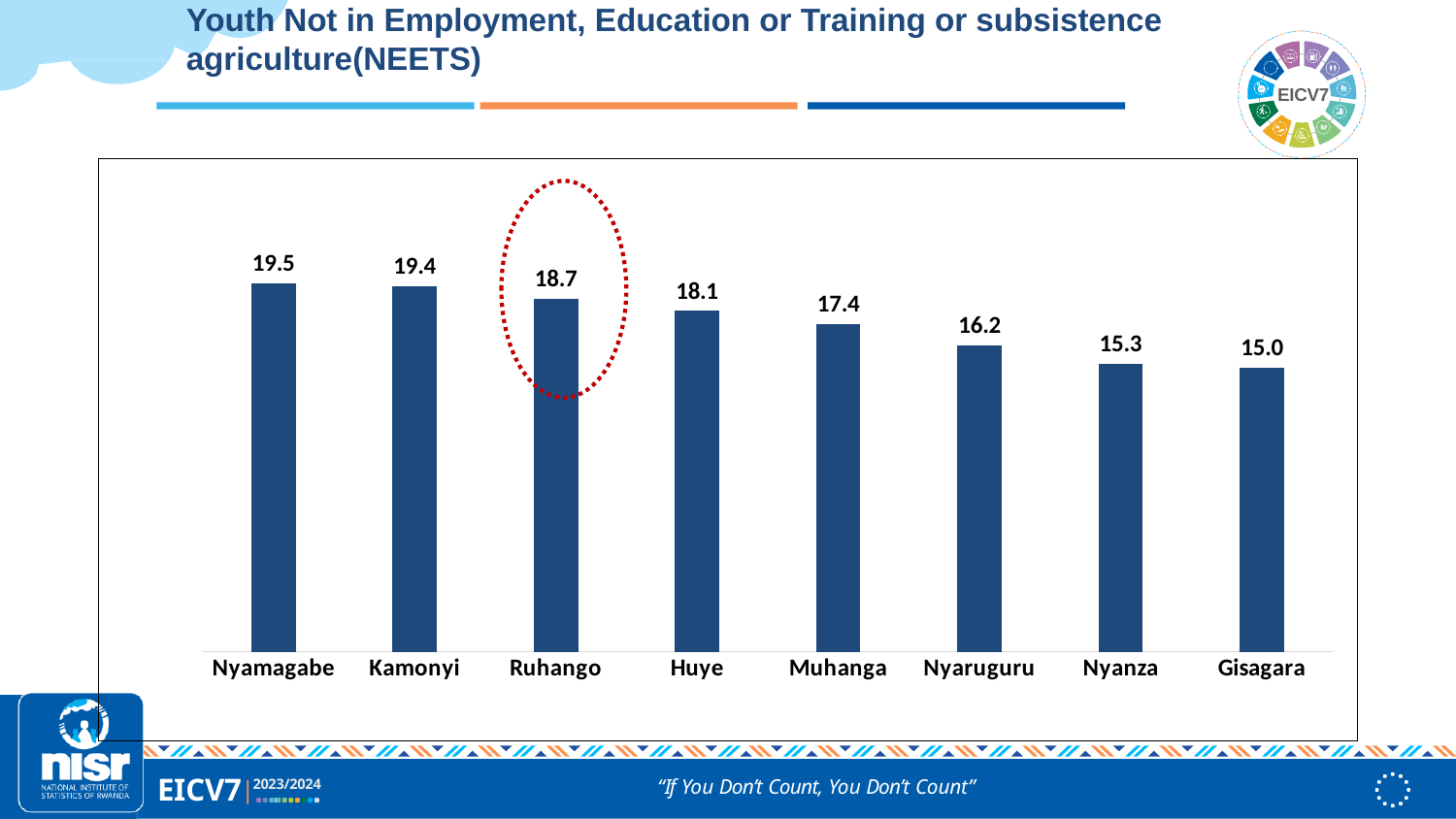
Which district's bar is circled with a red dotted outline? Ruhango Which is larger, the value for Kamonyi or the value for Nyanza? Kamonyi What kind of chart is shown on the slide? Bar chart What is the value for Gisagara? 15.0 Do the values rise or fall from left to right along the x axis? Fall What is the value for Ruhango? 18.7 How many districts are shown in the chart? 8 What is the difference between the values for Nyamagabe and Gisagara? 4.5 Which district has the lowest value? Gisagara What is the value for Nyaruguru? 16.2 What is the difference between the values for Huye and Muhanga? 0.7 Which district has the highest value? Nyamagabe